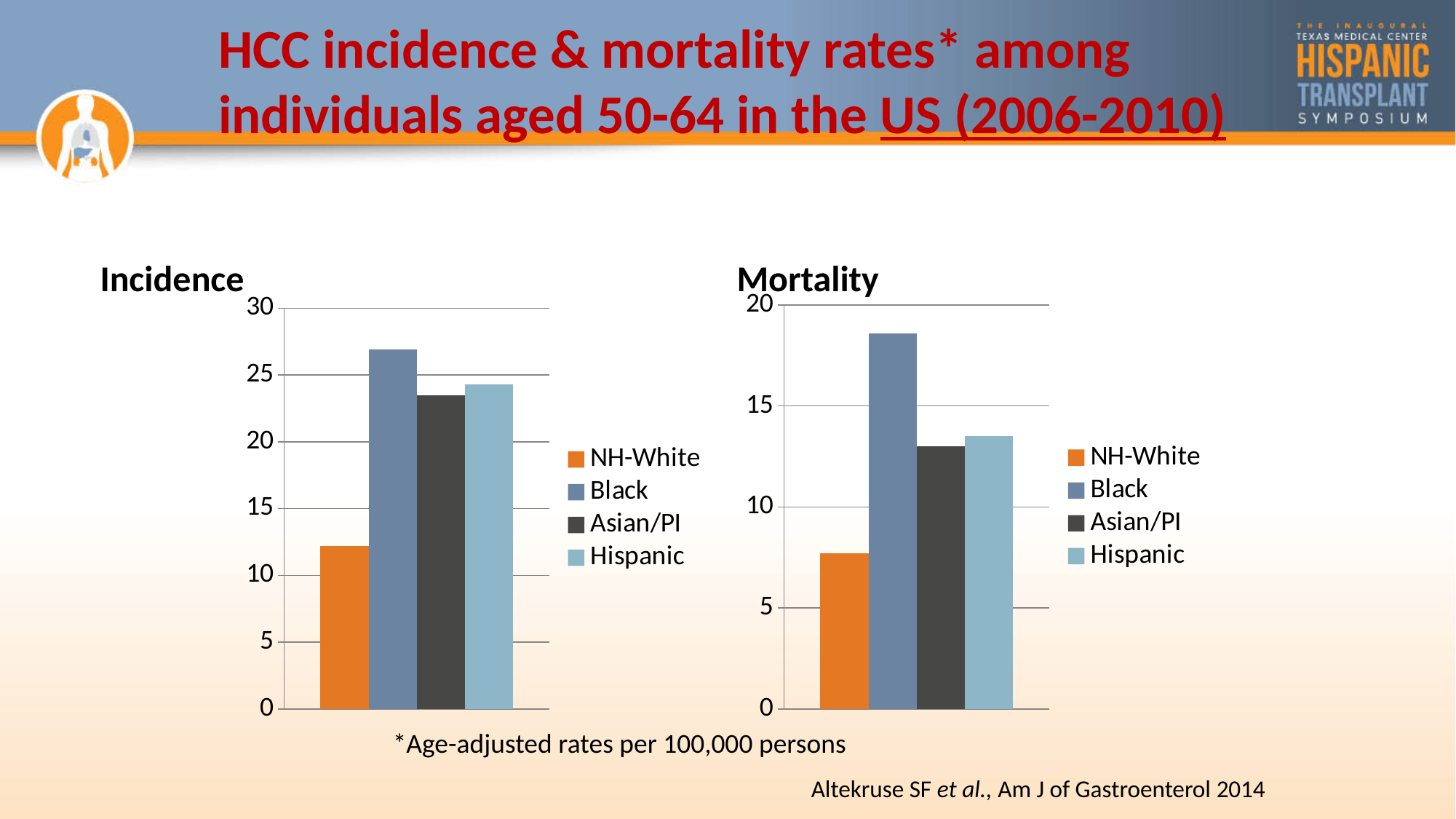
In the Incidence chart, is the value for NH-White greater or less than 15? less What kind of chart is the Mortality chart? bar chart In the Mortality chart, which is larger, the value for Black or the value for Hispanic? Black In the Incidence chart, which group is shown in orange? NH-White In the Incidence chart, which group has the highest bar? Black In the Incidence chart, which group has the lowest bar? NH-White In the Mortality chart, which group has the highest bar? Black In the Mortality chart, is the value for NH-White greater or less than 10? less In the Mortality chart, which group has the lowest bar? NH-White How many series does the legend of the Incidence chart list? 4 In the Incidence chart, is the value for Black greater or less than 25? greater